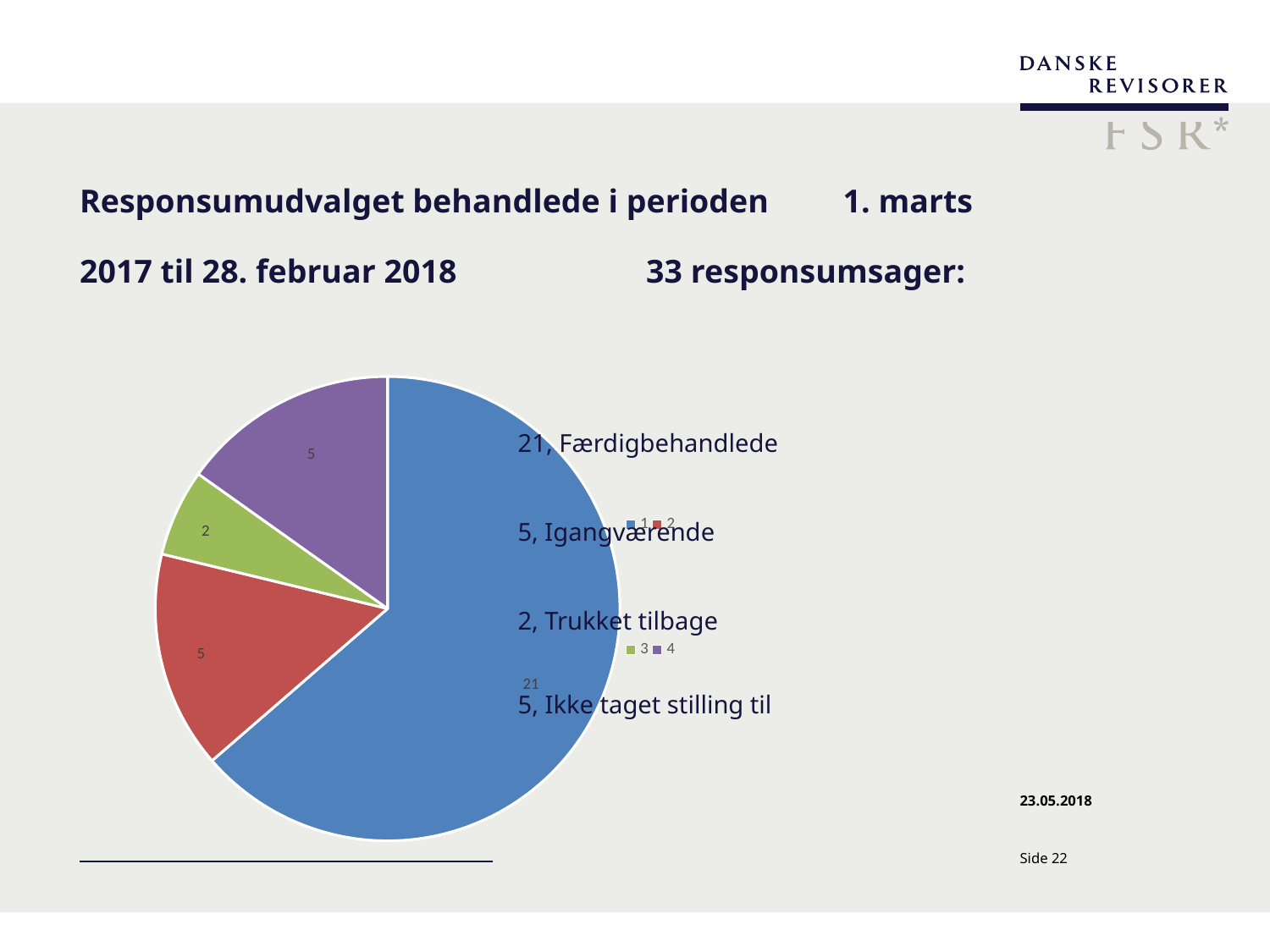
What is the total of all slice values in the pie chart? 33 What value is shown on the red slice of the pie chart? 5 How many entries does the legend of the pie chart list? 4 What value is shown on the green slice of the pie chart? 2 According to the text next to the chart, how many cases are 'Færdigbehandlede'? 21 Which slice of the pie chart is the largest? the blue slice (21) How many slices does the pie chart have? 4 What kind of chart is shown on the slide? pie chart Which is larger, the blue slice or the purple slice? the blue slice What value is shown on the largest (blue) slice of the pie chart? 21 Which slice of the pie chart is the smallest? the green slice (2) What is the difference between the blue slice (21) and the red slice (5)? 16